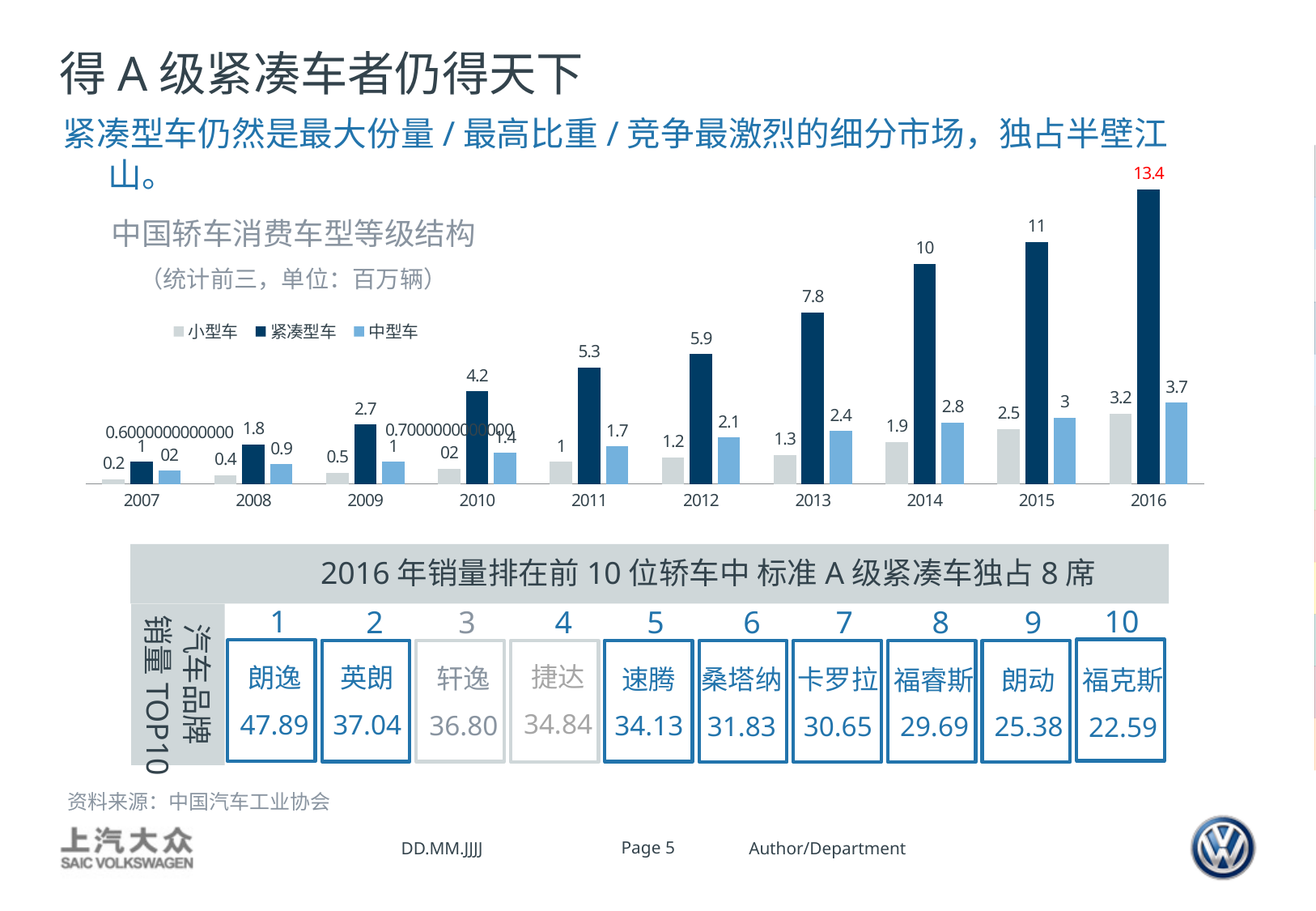
What is the title of the chart? 中国轿车消费车型等级结构 What is the difference between the 紧凑型车 values for 2016 and 2015? 2.4 What is the value for 中型车 in 2013? 2.4 What is the value for 紧凑型车 in 2016? 13.4 What type of chart is shown on the slide? bar chart How many years are shown on the x axis of the chart? 10 In which year is the value for 紧凑型车 highest? 2016 How many series does the legend of the chart list? 3 In which year is the value for 小型车 lowest? 2007 What is the value for 小型车 in 2015? 2.5 Which is larger in 2014: the value for 小型车 or the value for 中型车? 中型车 Does the value for 紧凑型车 rise or fall from 2007 to 2016? rise